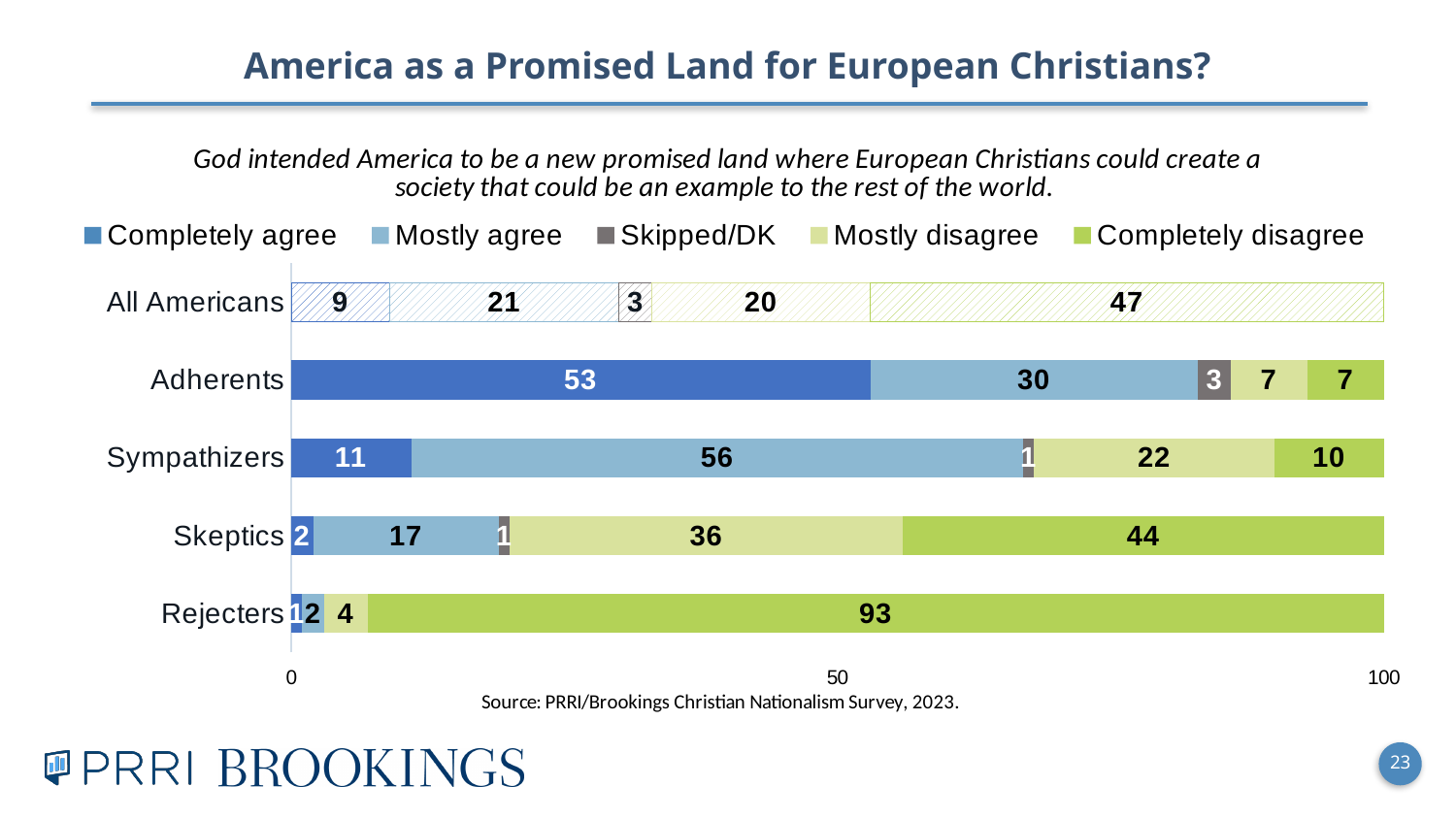
Which category has the lowest value for Completely agree? Rejecters What is the value for Mostly agree among Sympathizers? 56 What is the total of the stacked bar for Adherents? 100 Which has a larger Mostly disagree value, Skeptics or Sympathizers? Skeptics What kind of chart is shown on the slide? Stacked bar chart What is the value for Completely agree among Adherents? 53 Which category has the highest value for Completely disagree? Rejecters What is the difference between the Completely agree values for Adherents and Sympathizers? 42 What is the value for Completely disagree among Rejecters? 93 What is the value for Completely disagree among All Americans? 47 How many categories are shown on the chart? 5 How many series does the legend list? 5